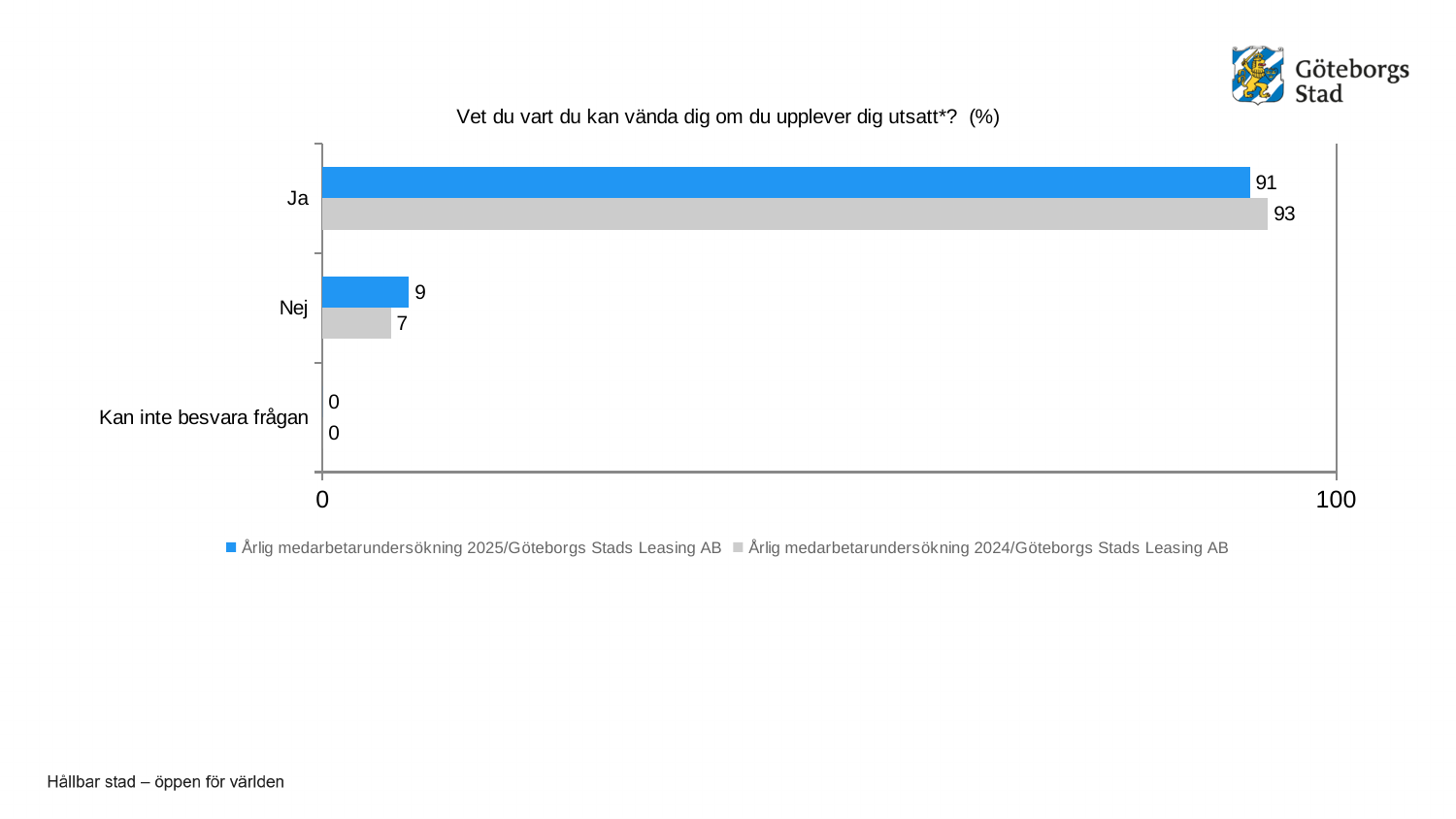
What is the value for "Ja" in the 2024 series (Årlig medarbetarundersökning 2024/Göteborgs Stads Leasing AB)? 93 What is the value for "Nej" in the 2025 series? 9 What kind of chart is shown on the slide? Bar chart How many series does the legend list? 2 Which category has the highest value in the 2025 series? Ja What is the difference between the 2025 and 2024 values for "Nej"? 2 What is the difference between the 2024 and 2025 values for "Ja"? 2 Which is larger for "Ja": the 2025 value or the 2024 value? 2024 What is the value for "Kan inte besvara frågan" in the 2025 series? 0 What is the value for "Nej" in the 2024 series? 7 What is the value for "Ja" in the 2025 series (Årlig medarbetarundersökning 2025/Göteborgs Stads Leasing AB)? 91 How many categories are shown on the chart? 3